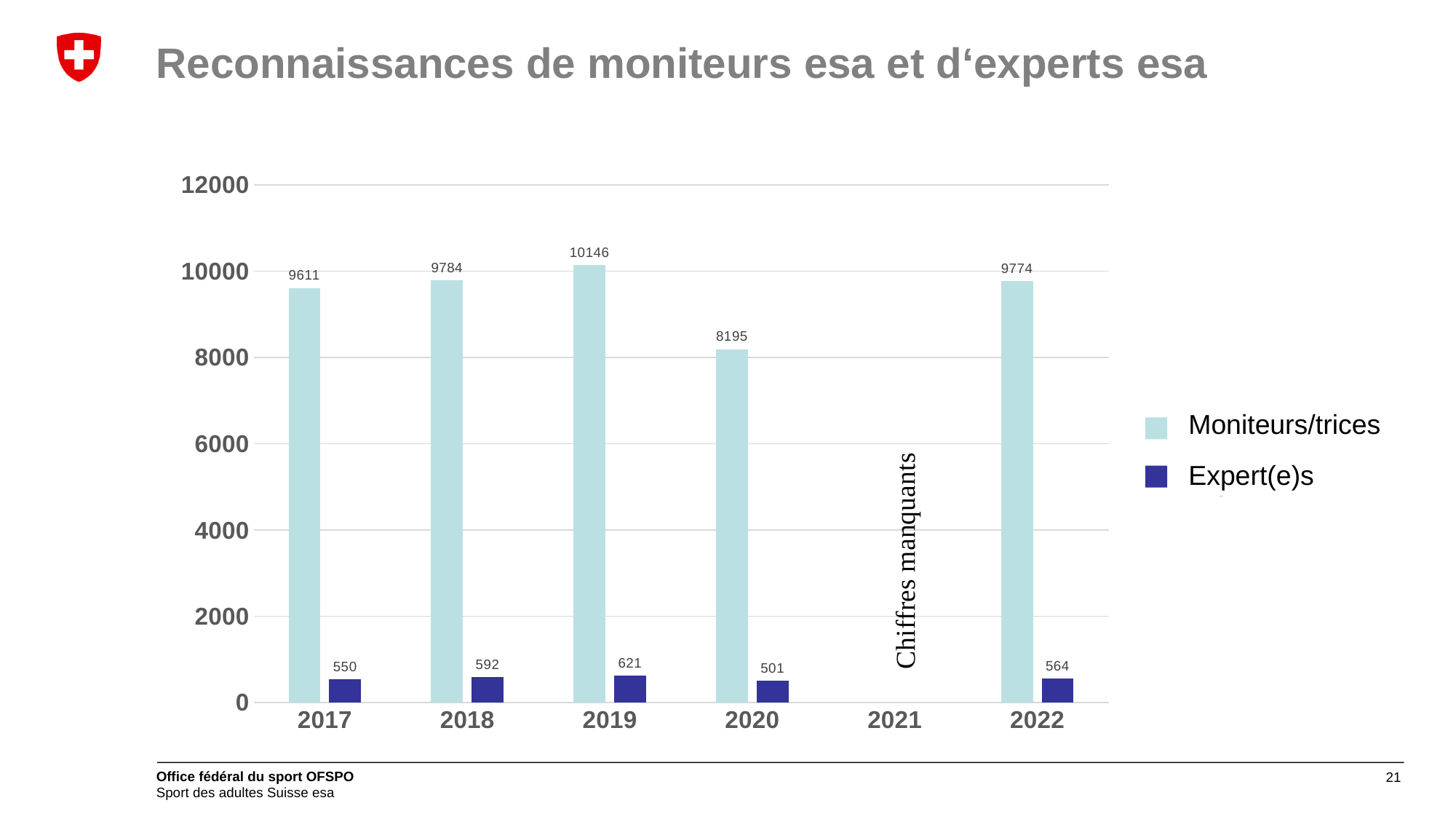
How many series does the legend list? 2 What kind of chart is shown on the slide? bar chart What is the value for Expert(e)s in 2020? 501 What text is shown in place of the bars for 2021? Chiffres manquants What is the value for Moniteurs/trices in 2022? 9774 Which is larger, the Expert(e)s value for 2018 or for 2022? 2018 Which year has the highest value for Moniteurs/trices? 2019 What is the value for Moniteurs/trices in 2019? 10146 Is the value for Moniteurs/trices in 2020 greater or less than 8000? greater How many years are shown on the x axis? 6 Which year has the lowest value for Expert(e)s? 2020 What is the difference between the Moniteurs/trices values for 2018 and 2020? 1589